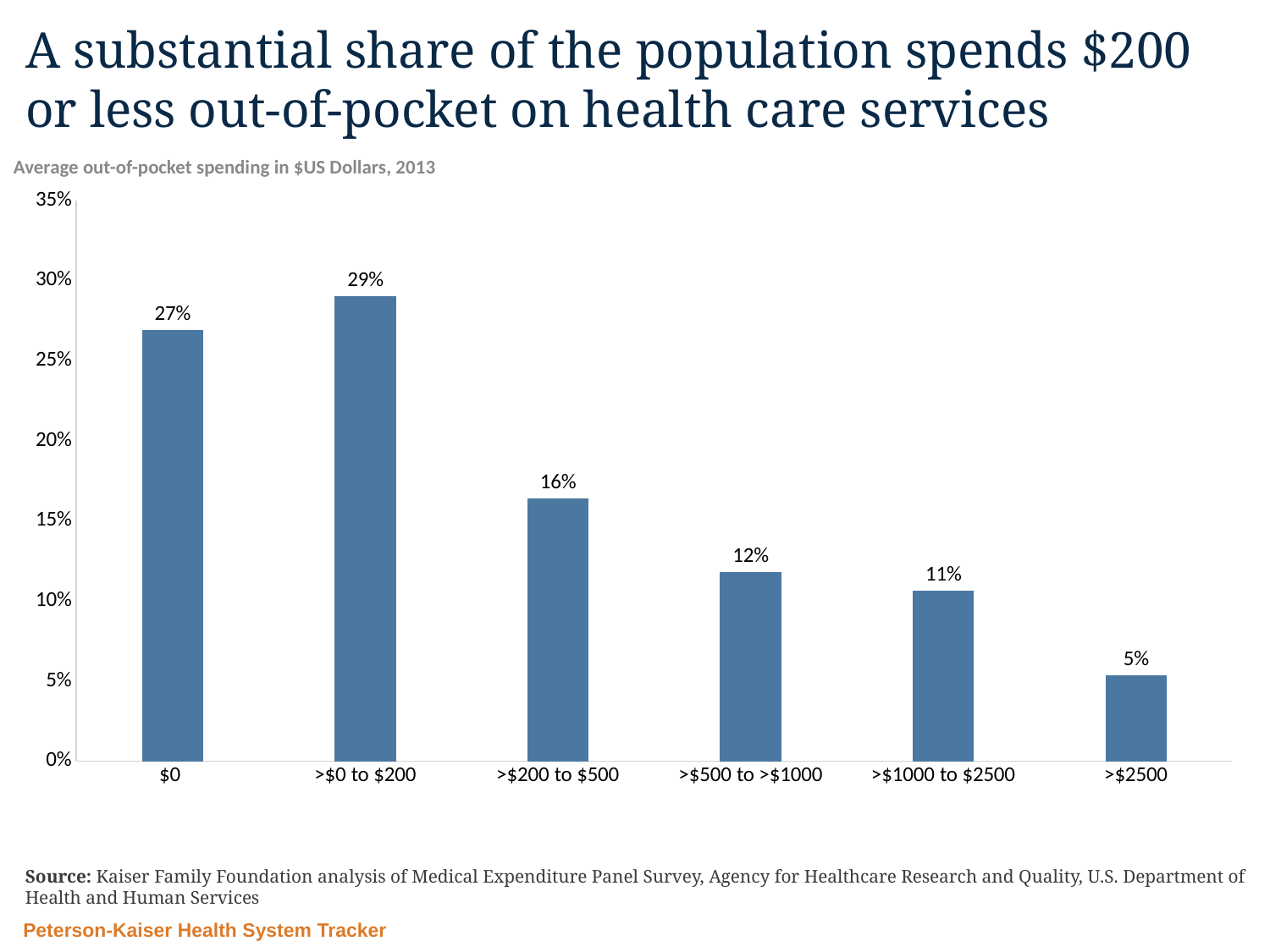
What kind of chart is shown on the slide? Bar chart Which is larger, the value for $0 or the value for >$0 to $200? >$0 to $200 What is the value for the >$0 to $200 category? 29% How many spending categories are shown on the chart? 6 What percentage of the population spends $0 out-of-pocket? 27% What is the value for the >$500 to >$1000 category? 12% What is the difference in percentage points between the >$0 to $200 category and the >$200 to $500 category? 13 percentage points Which spending category has the highest share of the population? >$0 to $200 Which spending category has the lowest share of the population? >$2500 Is the value for >$1000 to $2500 greater or less than 15%? less What is the subtitle printed above the chart? Average out-of-pocket spending in $US Dollars, 2013 What is the value for the >$2500 category? 5%